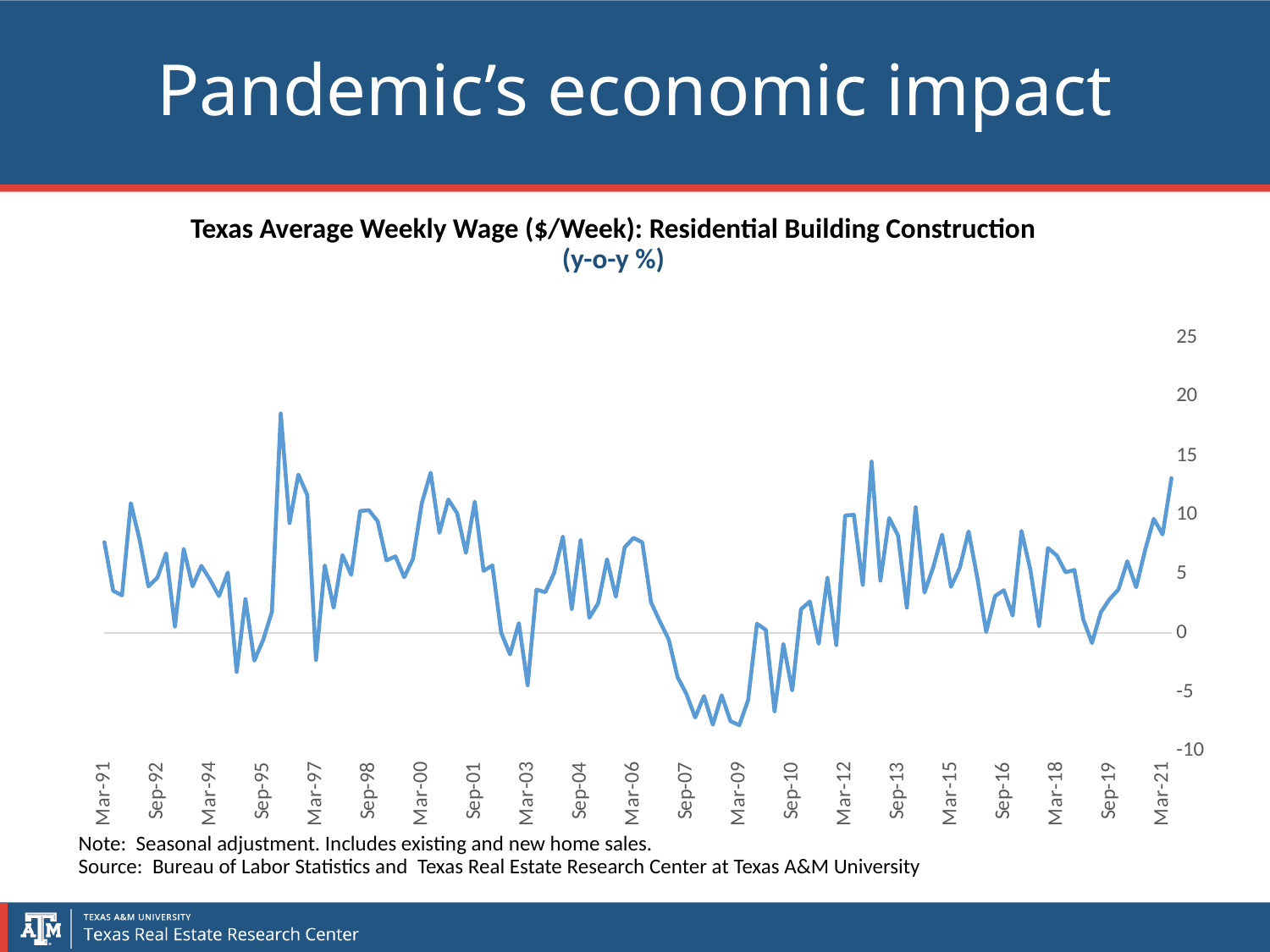
Is the value at Mar-91 greater or less than 5? greater Around which x-axis label does the line reach its lowest point? Mar-09 Is the value at Mar-21 greater or less than 10? less Is the value at Mar-09 greater or less than -5? less What is the highest value shown on the y axis? 25 What is the title of the chart? Texas Average Weekly Wage ($/Week): Residential Building Construction (y-o-y %) Do the values rise or fall between Mar-09 and Mar-12? rise Do the values rise or fall between Sep-19 and Mar-21? rise What kind of chart is shown on the slide? line chart How many labels are shown on the x axis? 21